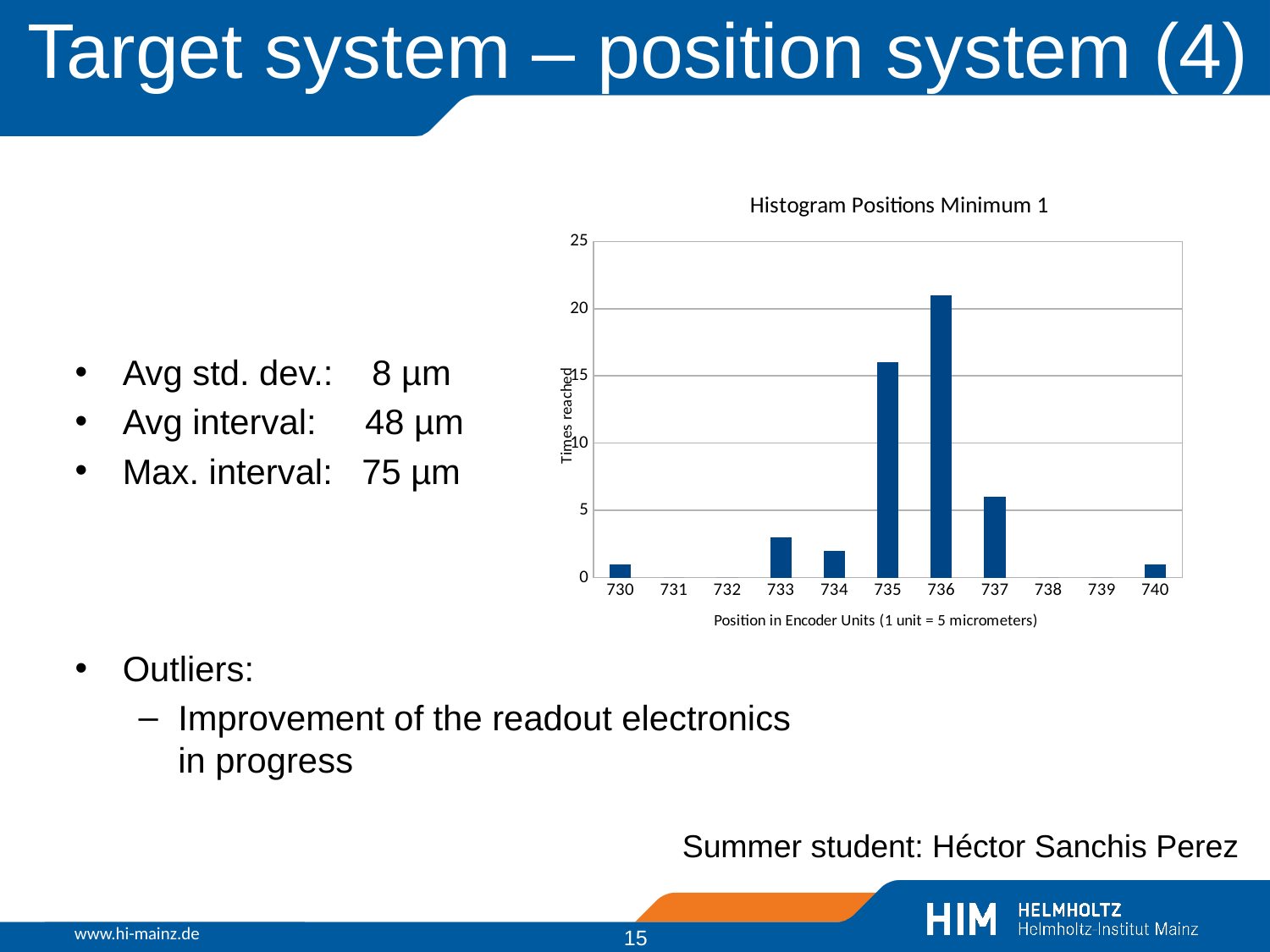
Which has a higher value, position 734 or position 737? 737 Which has a higher value, position 735 or position 737? 735 Which has a higher value, position 736 or position 735? 736 What type of chart is shown on the slide? bar chart What is the label of the x axis of the chart? Position in Encoder Units (1 unit = 5 micrometers) Which position has the highest number of times reached? 736 Is the value for position 735 greater or less than 15? greater What is the title of the chart? Histogram Positions Minimum 1 Is the value for position 737 greater or less than 10? less Is the value for position 733 greater or less than 5? less How many position categories are shown on the x axis of the chart? 11